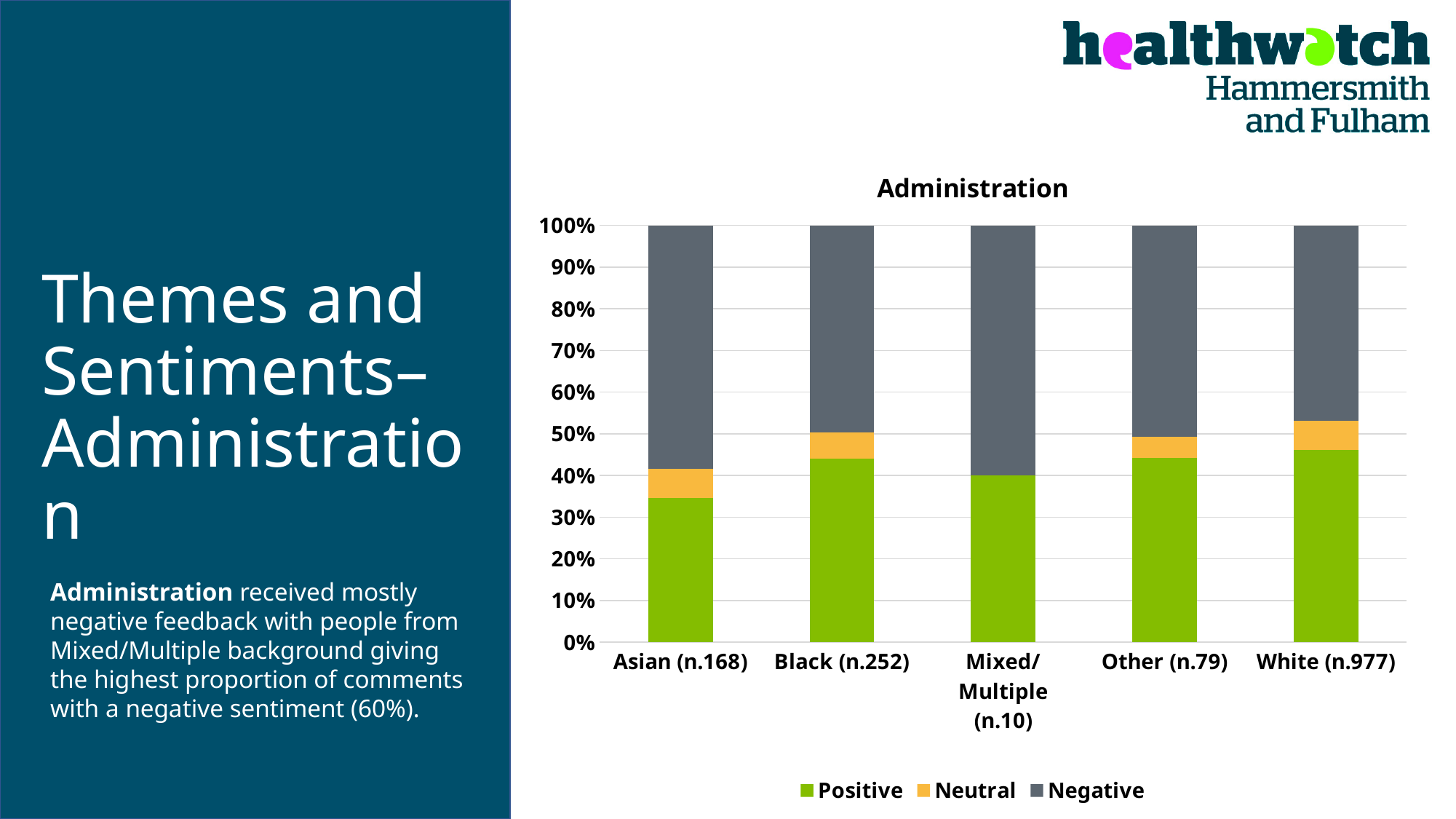
How many ethnic group categories are shown on the x axis of the Administration chart? 5 Which has the larger Positive share, Asian (n.168) or Black (n.252)? Black (n.252) Is the Positive share for White (n.977) greater or less than 40%? greater Is the Negative share for Mixed/Multiple (n.10) greater or less than 50%? greater According to the slide text, what proportion of comments from people of Mixed/Multiple background had a negative sentiment? 60% Which category shows no Neutral segment in its bar? Mixed/Multiple (n.10) What kind of chart is shown on the slide? Stacked bar chart Which has the larger Negative share, Asian (n.168) or White (n.977)? Asian (n.168) How many series does the legend of the Administration chart list? 3 Which category has the smallest Positive share? Asian (n.168) What is the title of the chart? Administration Is the Positive share for Asian (n.168) greater or less than 40%? less